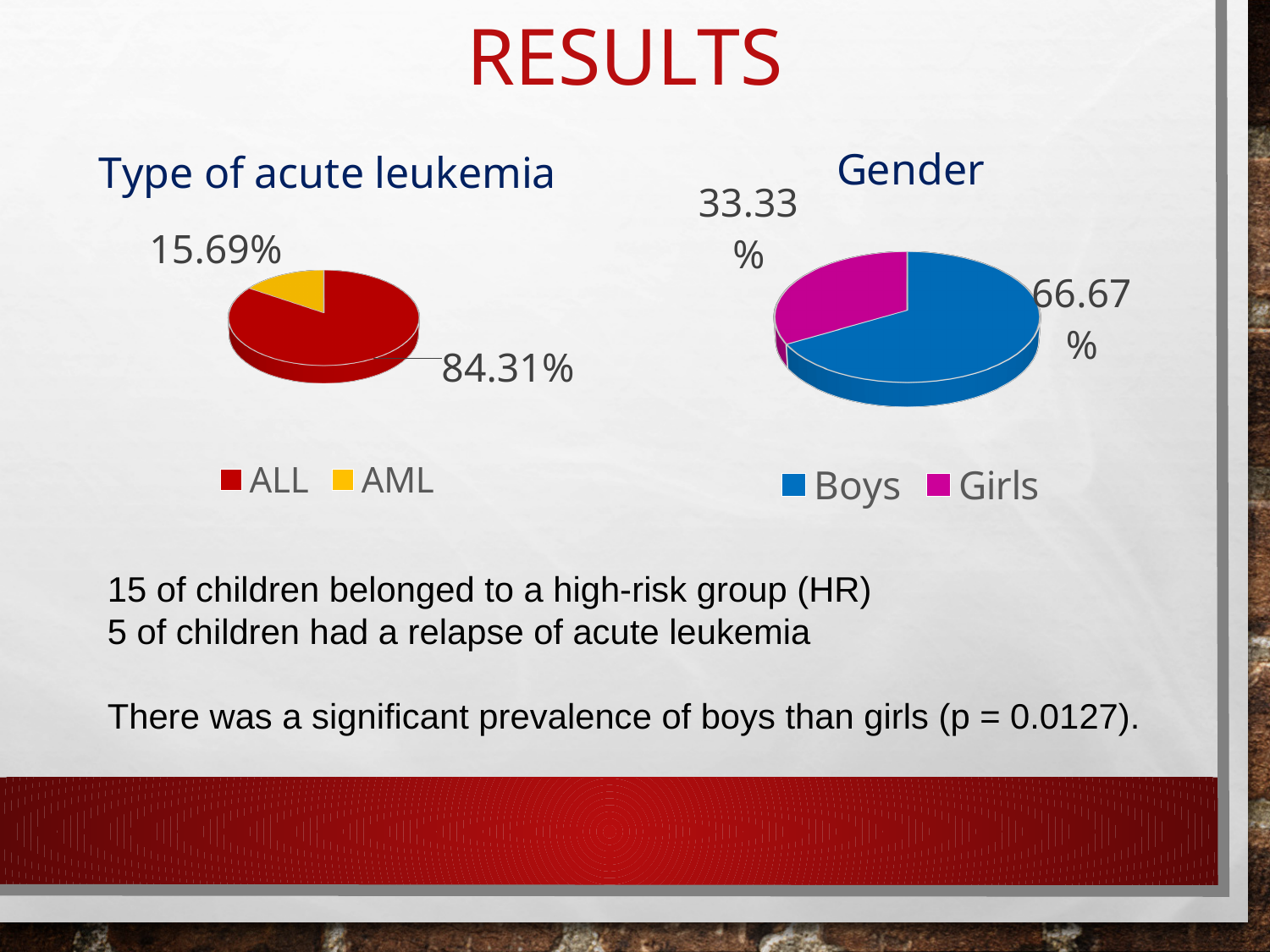
In the 'Type of acute leukemia' chart, what percentage is shown for ALL? 84.31% In the 'Gender' chart, what percentage is shown for Boys? 66.67% In the 'Type of acute leukemia' chart, which category has the largest slice? ALL In the 'Gender' chart, what percentage is shown for Girls? 33.33% What kind of chart is the 'Type of acute leukemia' chart? Pie chart In the 'Type of acute leukemia' chart, what percentage is shown for AML? 15.69% In the 'Type of acute leukemia' chart, what colour is the AML slice? Yellow How many categories does the legend of the 'Gender' chart list? 2 In the 'Gender' chart, which category has the smallest slice? Girls In the 'Type of acute leukemia' chart, what is the difference in percentage points between ALL and AML? 68.62 In the 'Gender' chart, which is larger, Boys or Girls? Boys In the 'Gender' chart, what is the difference in percentage points between Boys and Girls? 33.34